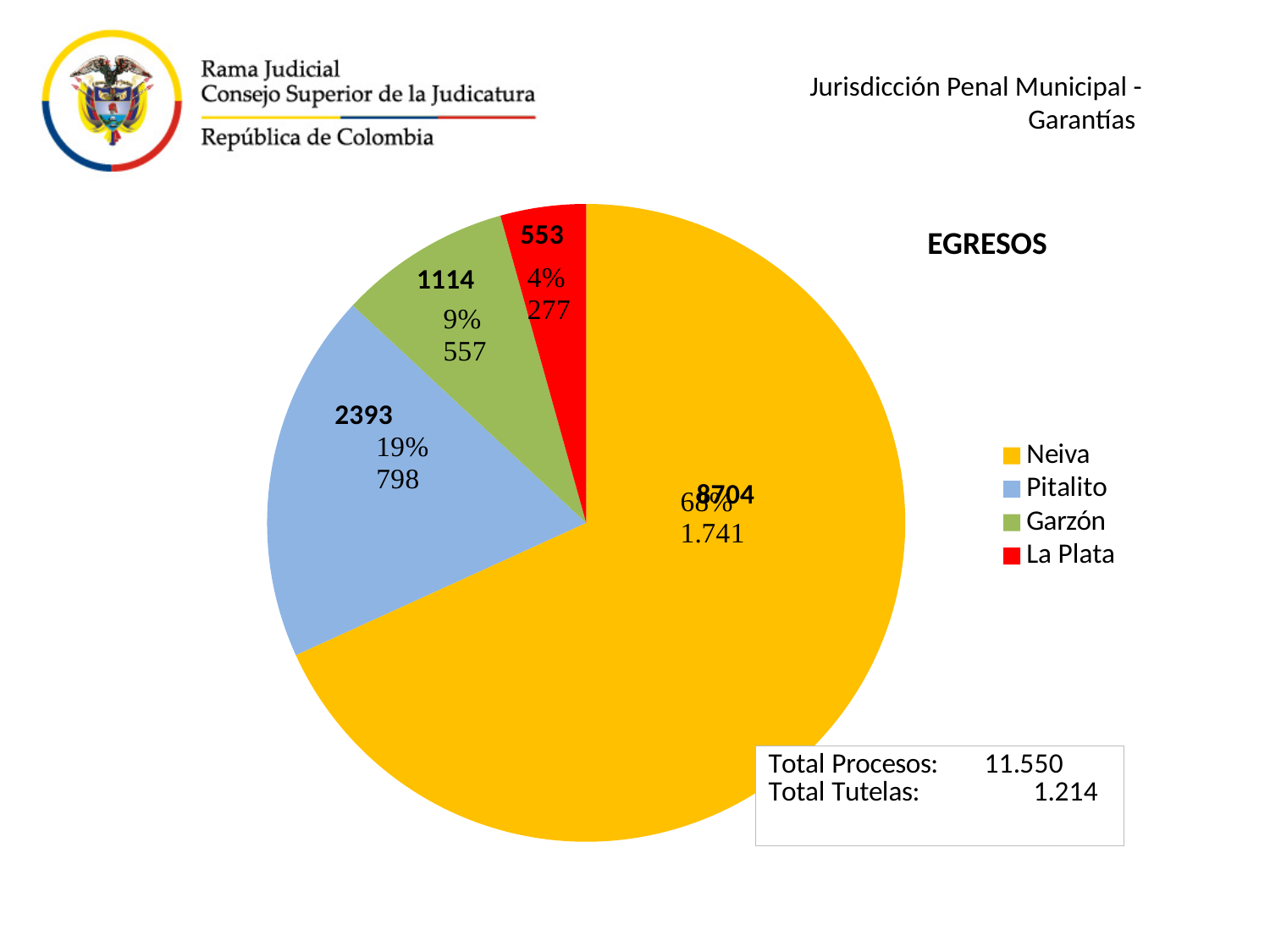
Which category has the smallest slice of the pie chart? La Plata Which colour represents Garzón in the pie chart? green How many categories does the legend of the pie chart list? 4 What is the difference between the values for Neiva and Pitalito? 6311 What is the title of the chart? EGRESOS What is the value shown for La Plata in the pie chart? 553 Which category has the largest slice of the pie chart? Neiva What percentage share of the pie does Pitalito have? 19% What type of chart is shown on the slide? pie chart What is the value shown for Pitalito in the pie chart? 2393 What is the value shown for Garzón in the pie chart? 1114 What is the value shown for Neiva in the pie chart? 8704